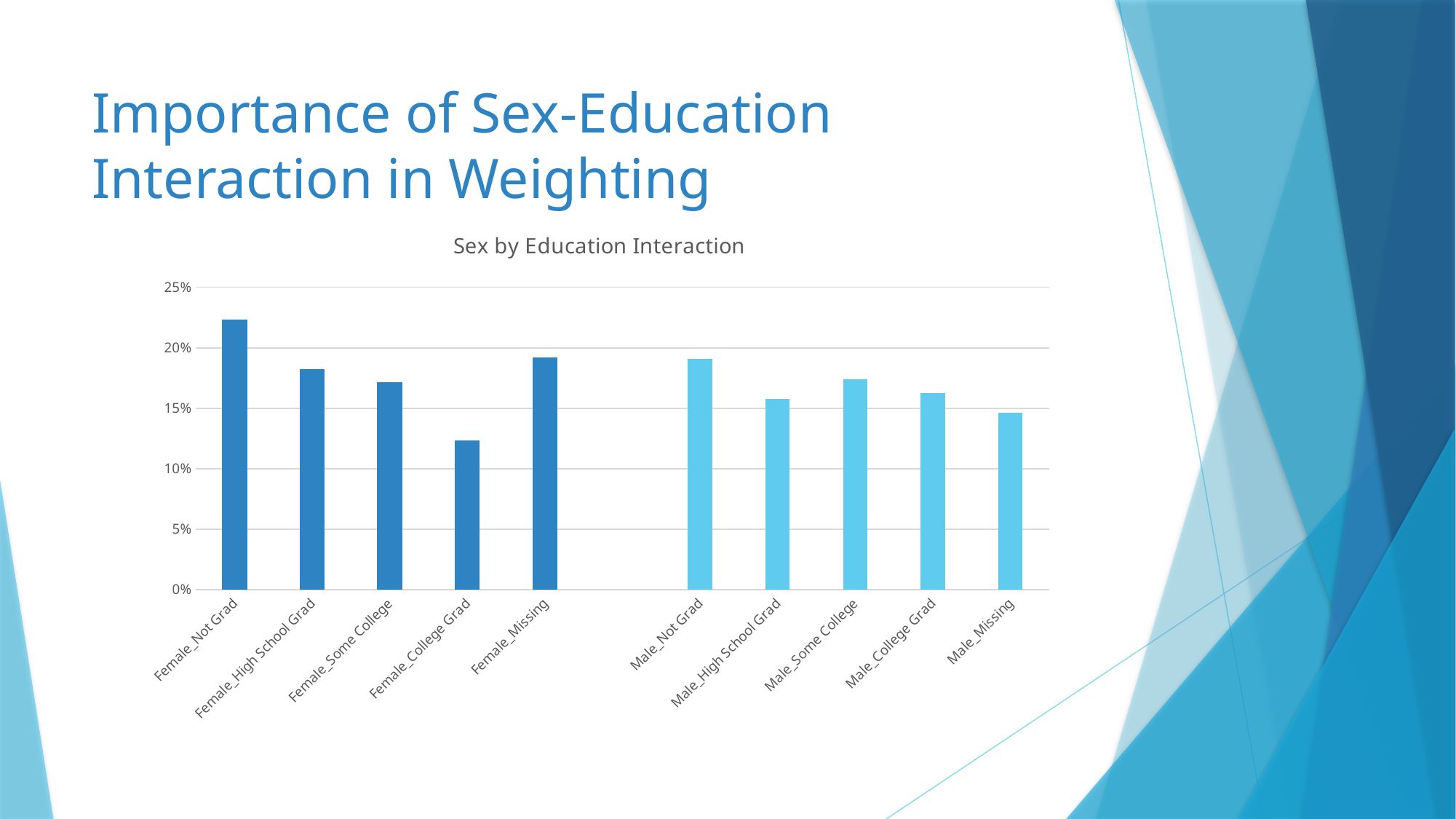
Is the value for Female_College Grad greater or less than 15%? less What is the title of the chart? Sex by Education Interaction Which is larger, the value for Female_High School Grad or Male_High School Grad? Female_High School Grad Is the value for Male_Not Grad greater or less than 20%? less Which category has the lowest value? Female_College Grad Which is larger, the value for Female_College Grad or Male_College Grad? Male_College Grad How many categories are plotted in the chart? 10 Is the value for Female_Not Grad greater or less than 20%? greater Which is larger, the value for Female_Not Grad or Male_Not Grad? Female_Not Grad Which category has the highest value? Female_Not Grad What kind of chart is shown on the slide? Bar chart